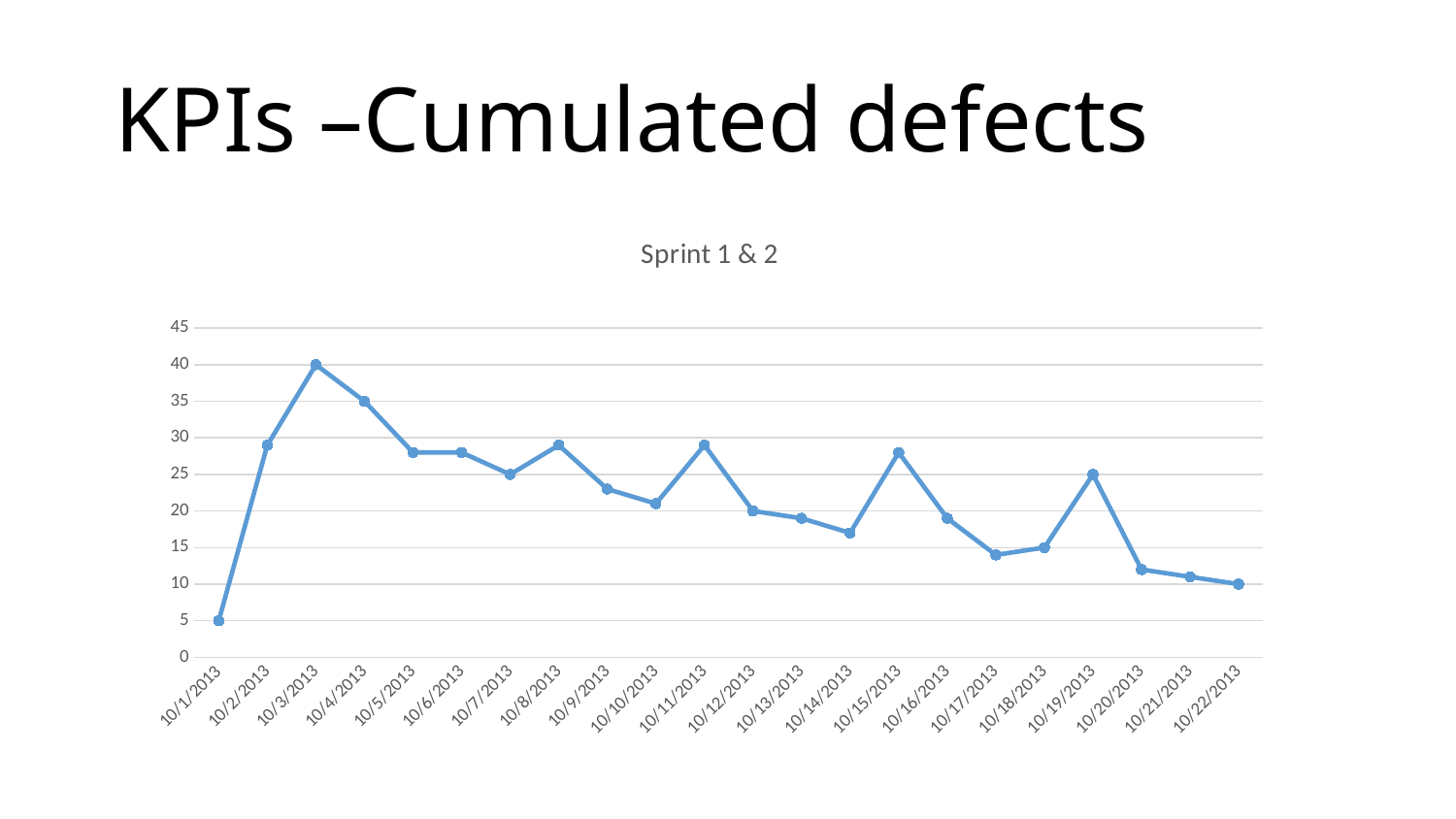
Which date has the larger value, 10/11/2013 or 10/14/2013? 10/11/2013 How many data points are plotted on the chart? 22 Is the value for 10/15/2013 greater or less than 25? greater What is the title of the chart? Sprint 1 & 2 What is the value for 10/3/2013? 40 What type of chart is shown on the slide? line chart What is the value for 10/22/2013? 10 What is the difference between the values for 10/3/2013 and 10/4/2013? 5 What is the value for 10/1/2013? 5 On which date is the plotted value lowest? 10/1/2013 On which date does the line reach its highest value? 10/3/2013 After the peak on 10/3/2013, do the values generally rise or fall toward 10/22/2013? fall